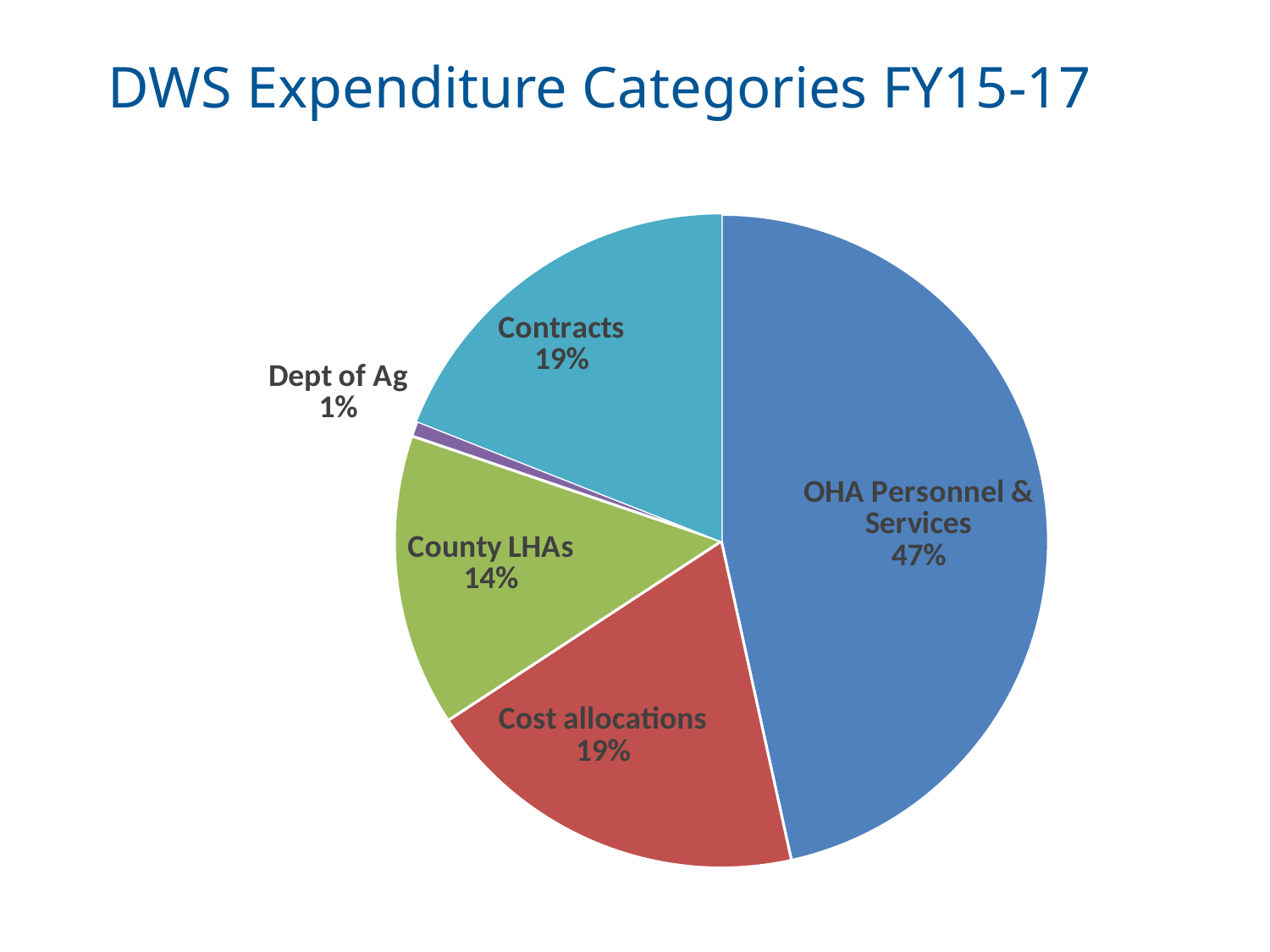
How many expenditure categories are shown in the pie chart? 5 What is the difference in percentage points between OHA Personnel & Services and Contracts? 28 Which is larger, the share for County LHAs or the share for Contracts? Contracts Which expenditure category has the largest share? OHA Personnel & Services What is the title of the chart? DWS Expenditure Categories FY15-17 What colour is the OHA Personnel & Services slice? blue What percentage of expenditures goes to County LHAs? 14% What kind of chart is shown on the slide? pie chart What percentage is shown for Cost allocations? 19% What share of expenditures is Dept of Ag? 1% What share of DWS expenditures is OHA Personnel & Services? 47% Which expenditure category has the smallest share? Dept of Ag